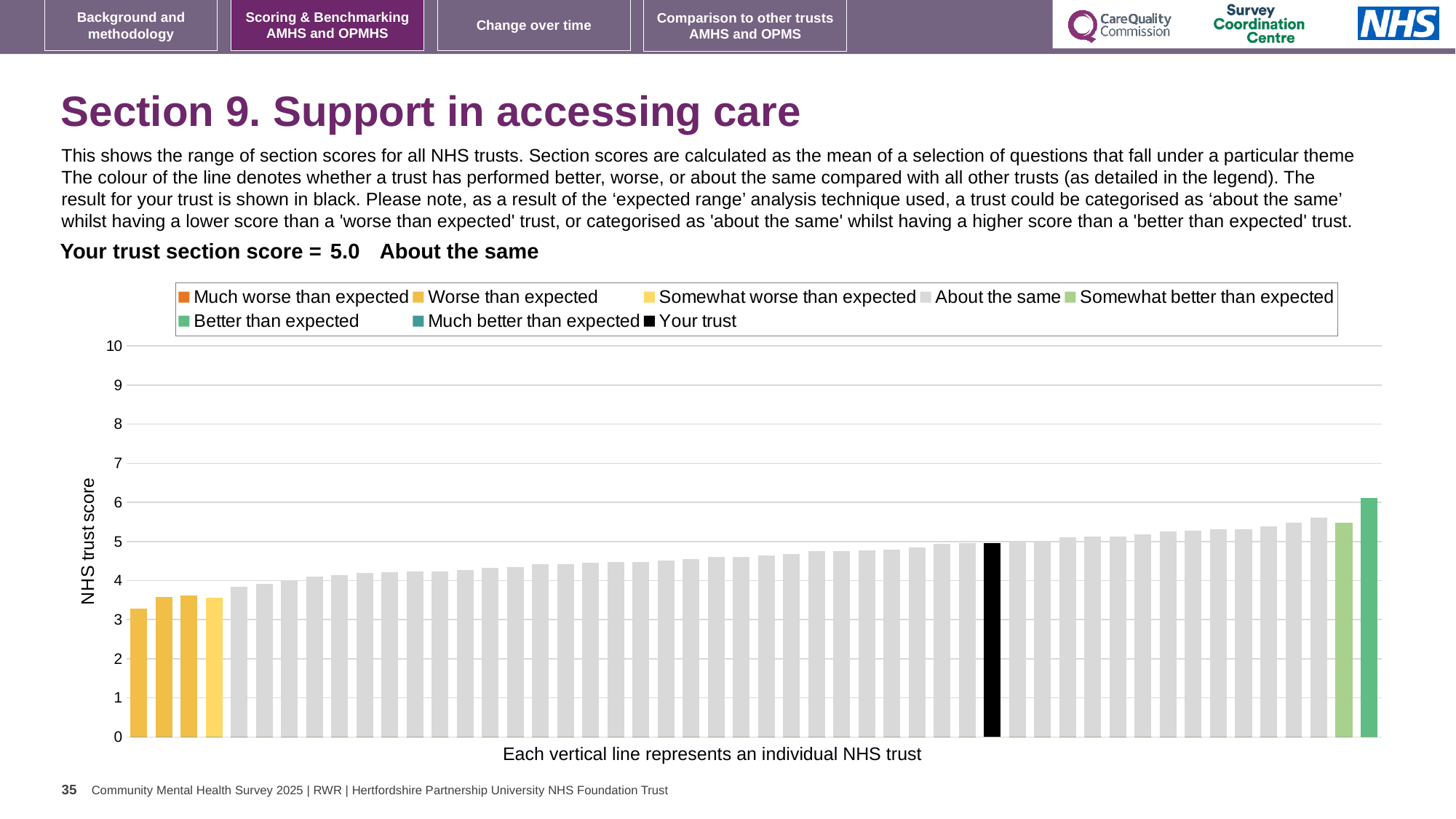
Which legend category does the tallest bar belong to? Better than expected What is the title of the y axis? NHS trust score Is the shortest bar in the chart greater or less than 4? less Is the value for your trust (the black bar) greater or less than 4? greater Which category is your trust placed in according to the slide? About the same How many entries does the chart legend list? 8 Is the value for your trust (the black bar) greater or less than 6? less What is the section score for your trust? 5.0 Do the bar values rise or fall from left to right along the x axis? rise What kind of chart is shown on the slide? bar chart